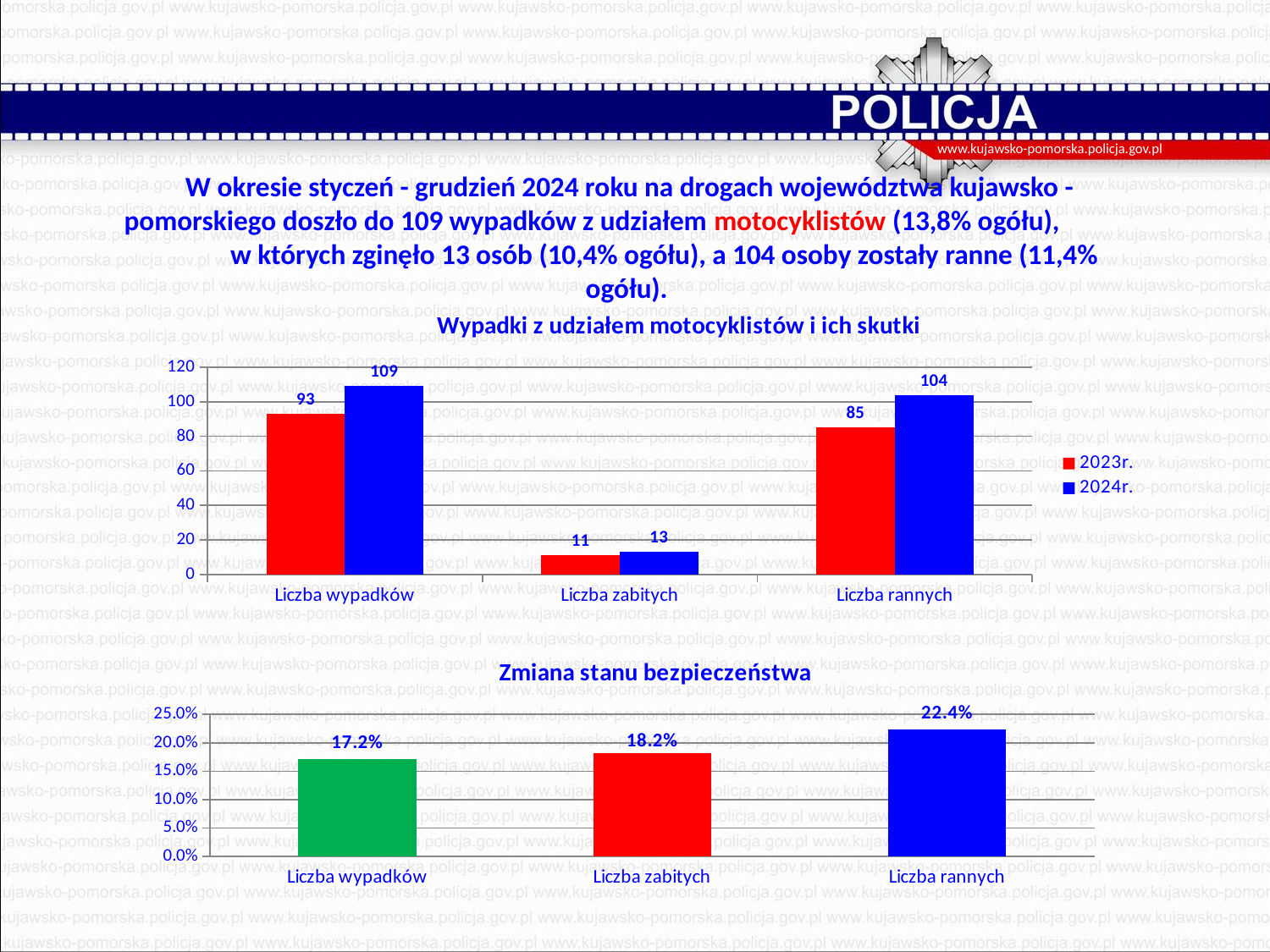
What kind of chart is 'Zmiana stanu bezpieczeństwa'? bar chart How many categories are shown on the x axis of the chart 'Zmiana stanu bezpieczeństwa'? 3 In the chart 'Zmiana stanu bezpieczeństwa', what is the value for 'Liczba rannych'? 22.4% In the chart 'Wypadki z udziałem motocyklistów i ich skutki', what is the value for 'Liczba zabitych' in 2023r.? 11 In the chart 'Wypadki z udziałem motocyklistów i ich skutki', which category has the lowest values? Liczba zabitych In the chart 'Wypadki z udziałem motocyklistów i ich skutki', what is the value for 'Liczba wypadków' in 2024r.? 109 In the chart 'Wypadki z udziałem motocyklistów i ich skutki', what is the difference between the 2024r. and 2023r. values for 'Liczba rannych'? 19 In the chart 'Zmiana stanu bezpieczeństwa', what is the difference between 'Liczba zabitych' and 'Liczba wypadków'? 1.0% How many series does the legend of the chart 'Wypadki z udziałem motocyklistów i ich skutki' list? 2 In the chart 'Wypadki z udziałem motocyklistów i ich skutki', what is the value for 'Liczba rannych' in 2024r.? 104 In the chart 'Zmiana stanu bezpieczeństwa', which category has the highest value? Liczba rannych In the chart 'Wypadki z udziałem motocyklistów i ich skutki', which is larger for 'Liczba wypadków': 2023r. or 2024r.? 2024r.